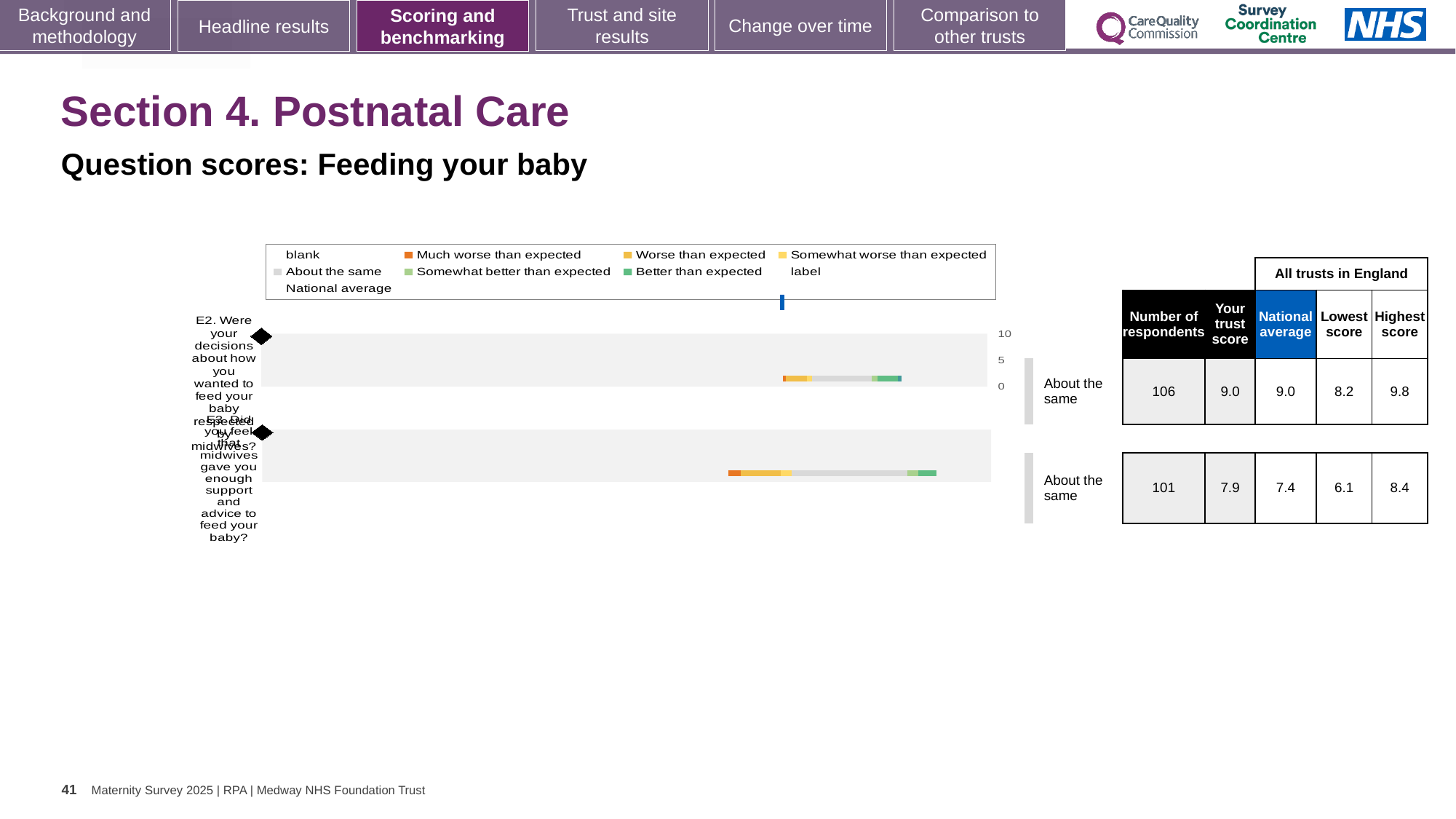
Which is larger for question E3: the trust score or the National average? the trust score Which legend entry is shown in dark orange? Much worse than expected What is the highest tick value shown on the chart's axis? 10 What is the 'Your trust score' for question E2 (decisions about how you wanted to feed your baby respected by midwives)? 9.0 What is the National average for question E3? 7.4 What is the difference between the Highest score and the Lowest score for question E2? 1.6 Which question has the higher Lowest score across all trusts in England? E2 What is the difference between the Highest score and the Lowest score for question E3? 2.3 What is the 'Your trust score' for question E3 (midwives gave you enough support and advice to feed your baby)? 7.9 How many questions (categories) are plotted in the chart? 2 What kind of chart is shown on the slide? bar chart How many respondents answered question E2? 106